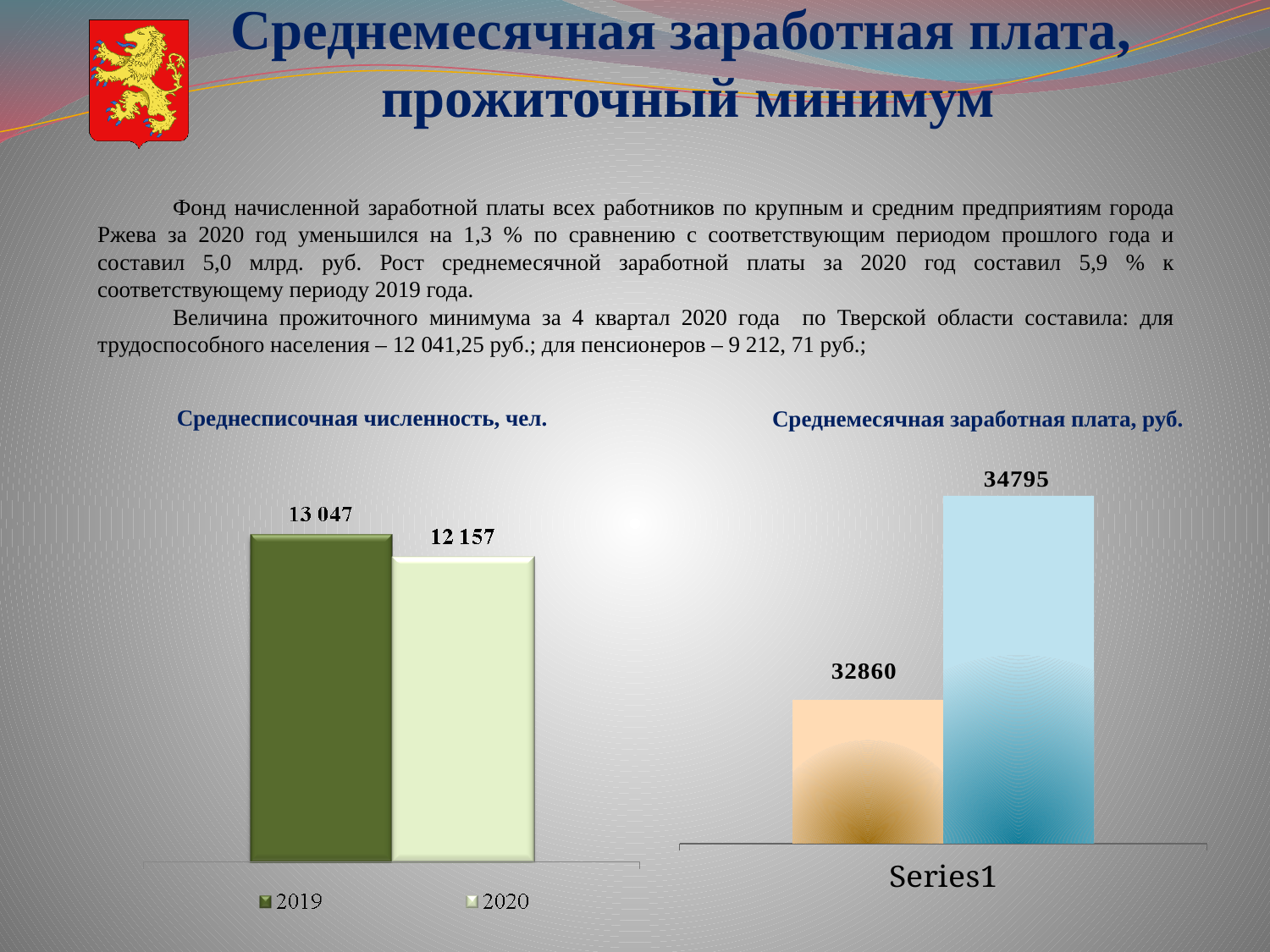
On the chart titled 'Среднемесячная заработная плата, руб.', what is the difference between the two bars? 1935 On the chart titled 'Среднесписочная численность, чел.', what is the value for 2019? 13 047 On the chart titled 'Среднесписочная численность, чел.', what is the value for 2020? 12 157 On the chart titled 'Среднемесячная заработная плата, руб.', what is the value of the left (orange) bar? 32860 On the chart titled 'Среднемесячная заработная плата, руб.', how many bars are plotted? 2 On the chart titled 'Среднемесячная заработная плата, руб.', what is the value of the right (blue) bar? 34795 On the chart titled 'Среднесписочная численность, чел.', how many series does the legend list? 2 On the chart titled 'Среднесписочная численность, чел.', what kind of chart is shown? bar chart On the chart titled 'Среднесписочная численность, чел.', which year has the higher value? 2019 On the chart titled 'Среднемесячная заработная плата, руб.', what is the category label shown on the x axis? Series1 On the chart titled 'Среднемесячная заработная плата, руб.', which bar is taller, the orange one or the blue one? the blue one On the chart titled 'Среднесписочная численность, чел.', what is the difference between the 2019 and 2020 values? 890